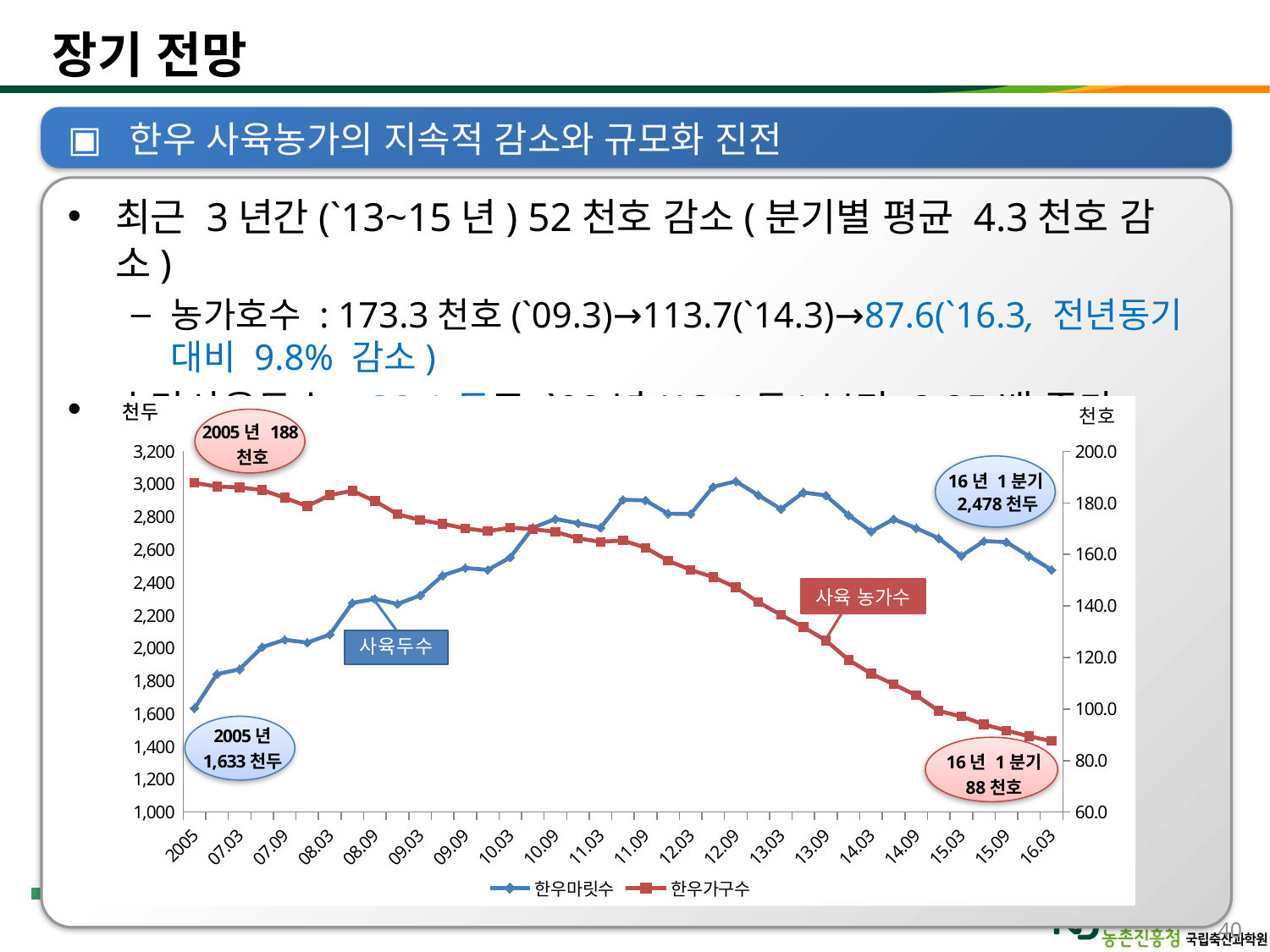
By how much did 한우가구수 decrease from 2005 to 16년 1분기? 100 천호 What are the two series named in the chart legend? 한우마릿수, 한우가구수 What is the value of 한우마릿수 in 16년 1분기 according to the callout? 2,478 천두 What is the value of 한우마릿수 in 2005 according to the callout? 1,633 천두 At which point on the x axis is 한우가구수 lowest? 16.03 Does 한우가구수 rise or fall along the x axis from 2005 to 16.03? fall How many series does the chart legend list? 2 What is the value of 한우가구수 in 16년 1분기 according to the callout? 88 천호 Is the value for 한우마릿수 at 12.09 greater or less than 2,800? greater What type of chart is shown on the slide? line chart What is the value of 한우가구수 in 2005 according to the callout? 188 천호 By how much did 한우마릿수 increase from 2005 to 16년 1분기? 845 천두